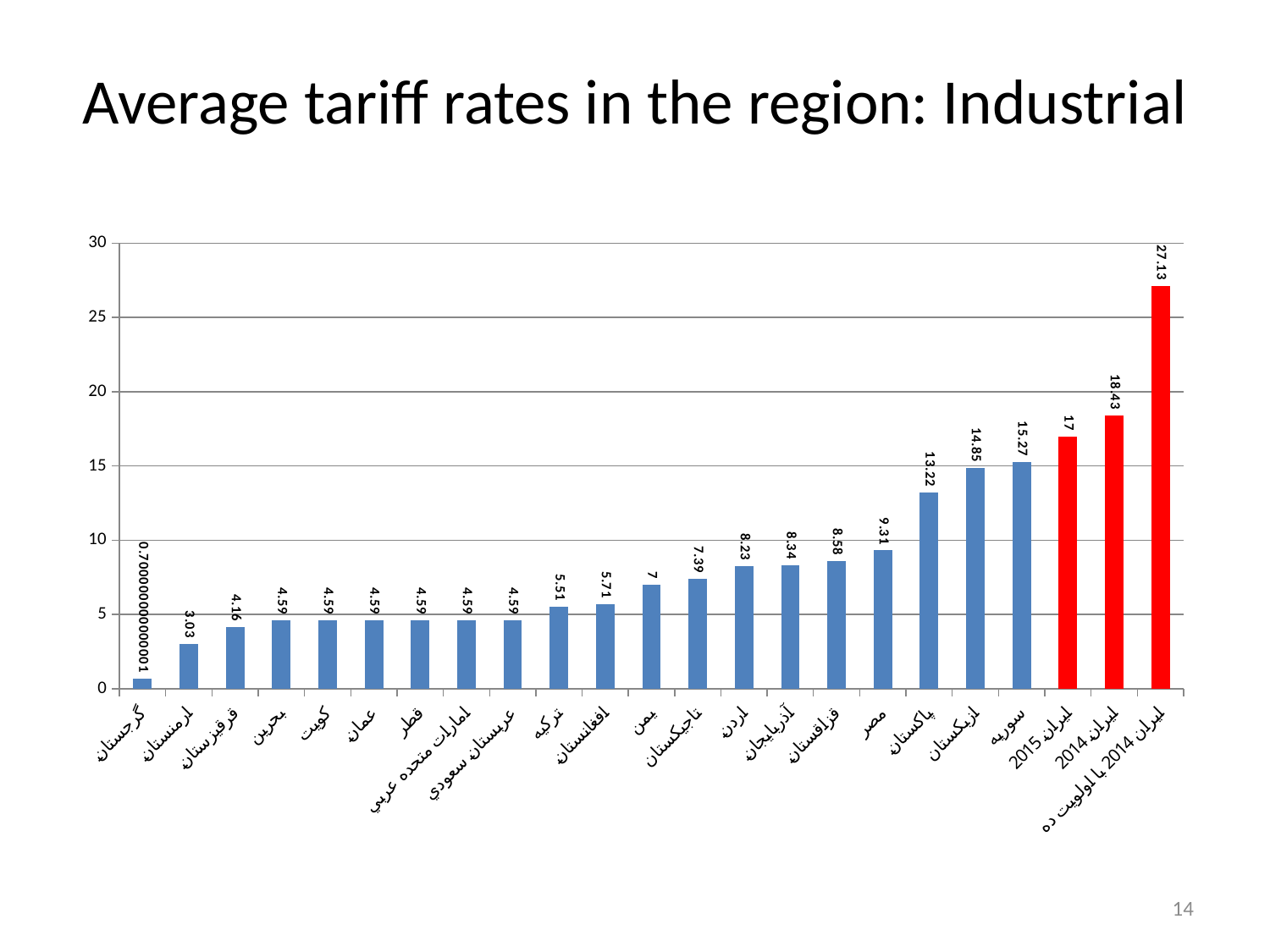
What is the value shown for پاکستان? 13.22 What is the value shown for ایران 2015? 17 What kind of chart is shown on the slide? bar chart What is the difference between the values for سوریه and ازبکستان? 0.42 What is the value shown for مصر? 9.31 Is the value for ایران 2014 با اولویت ده greater or less than 25? greater Which category has the highest value? ایران 2014 با اولویت ده Which category has the lowest value? گرجستان What is the difference between the values for ایران 2014 and ایران 2015? 1.43 Which is larger, the value for ترکیه or the value for افغانستان? افغانستان How many bars are coloured red? 3 How many categories are shown on the x axis? 23